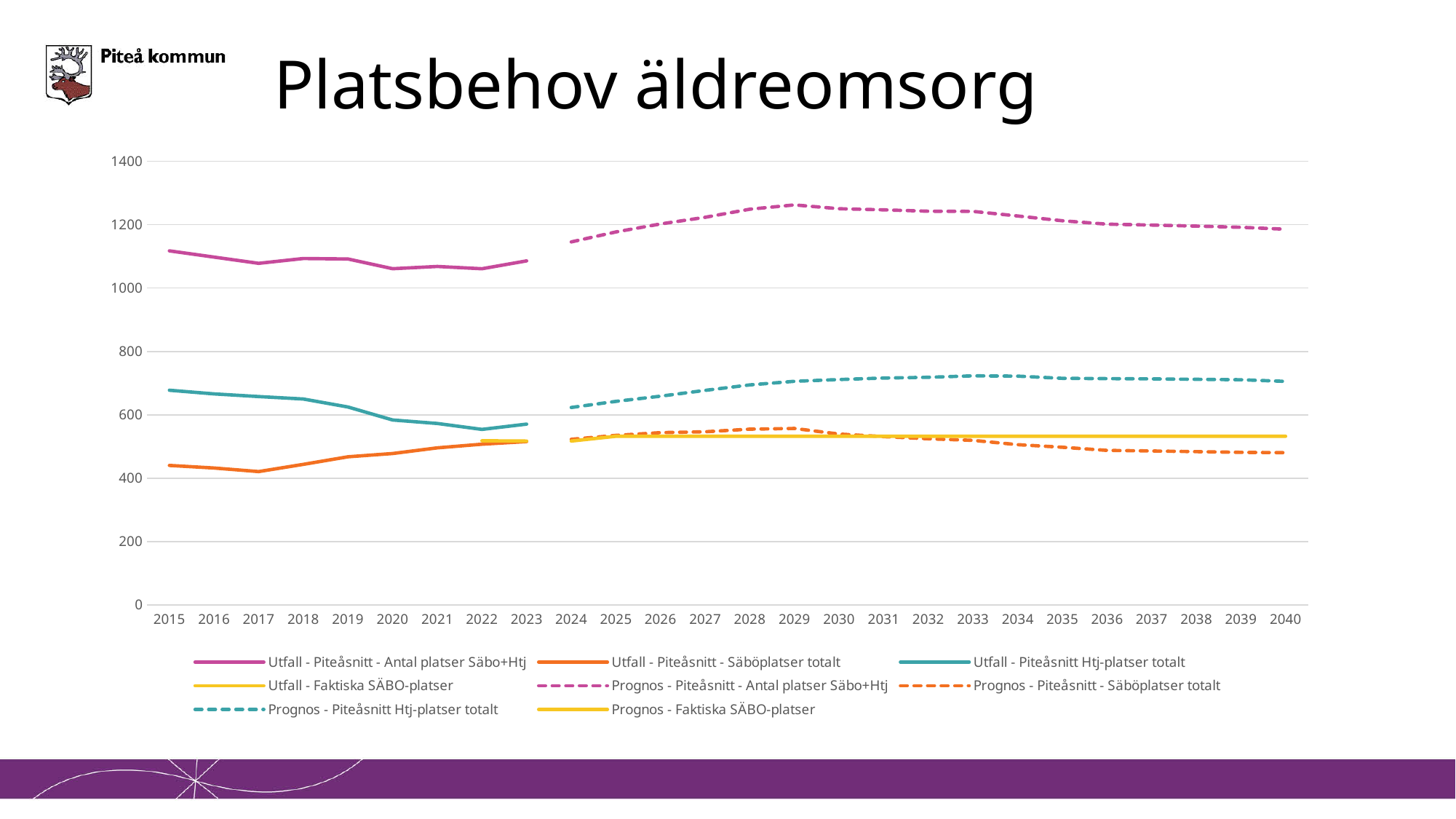
Does the 'Utfall - Piteåsnitt - Säböplatser totalt' line rise or fall from 2017 to 2023? rise How many years are shown on the x axis? 26 How many series does the legend list? 8 Is the value for 'Utfall - Piteåsnitt - Antal platser Säbo+Htj' in 2015 greater or less than 1000? greater Is the value for 'Prognos - Piteåsnitt Htj-platser totalt' in 2040 greater or less than 600? greater Is the value for 'Prognos - Piteåsnitt - Antal platser Säbo+Htj' in 2029 greater or less than 1200? greater In which year does 'Prognos - Piteåsnitt - Antal platser Säbo+Htj' reach its highest value? 2029 Does the 'Utfall - Piteåsnitt Htj-platser totalt' line rise or fall from 2015 to 2022? fall In 2040, which is larger: 'Prognos - Piteåsnitt Htj-platser totalt' or 'Prognos - Piteåsnitt - Säböplatser totalt'? Prognos - Piteåsnitt Htj-platser totalt What is the title of the slide's chart? Platsbehov äldreomsorg What kind of chart is shown on the slide? line chart